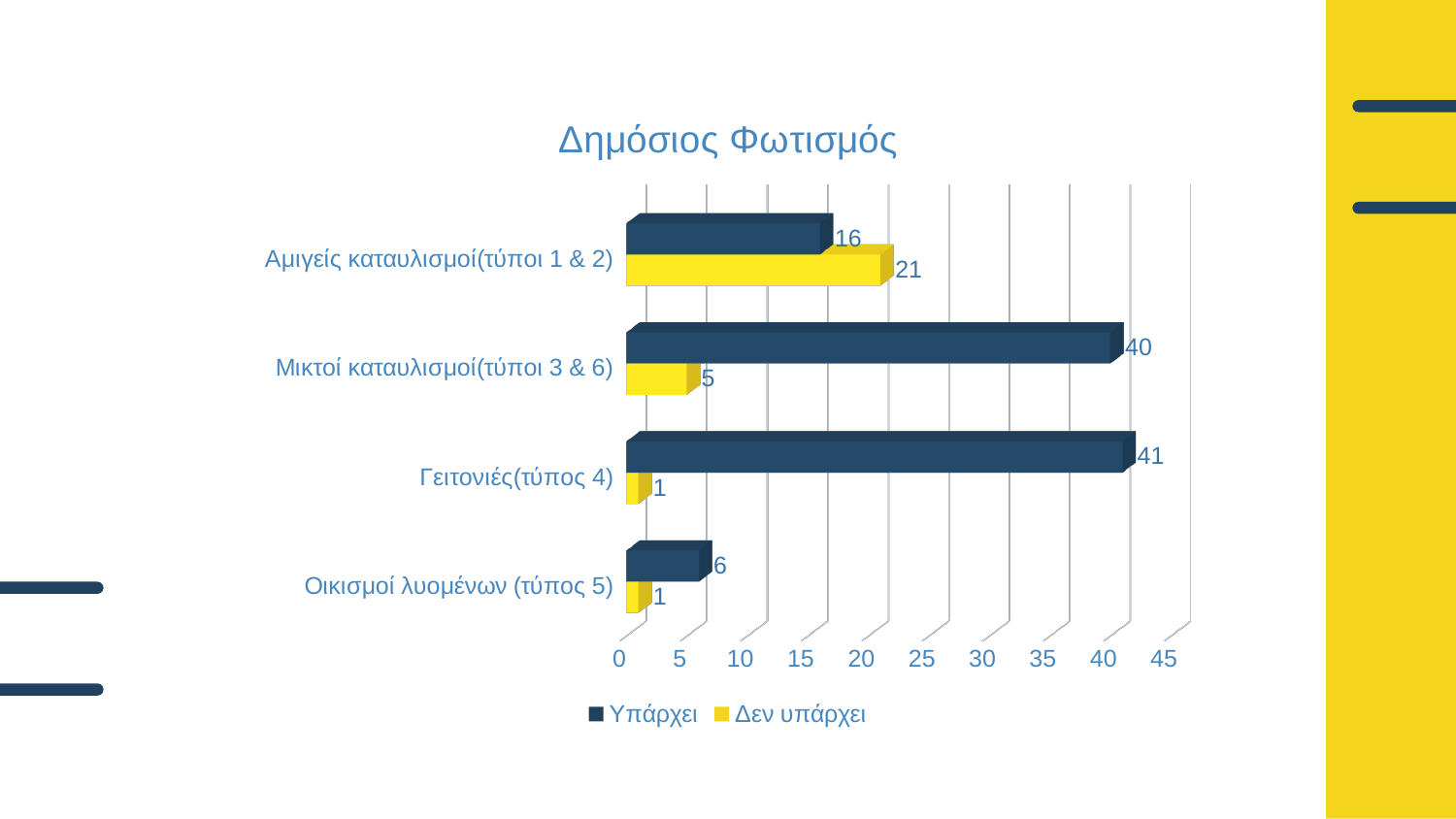
What is the value of Δεν υπάρχει for Αμιγείς καταυλισμοί(τύποι 1 & 2)? 21 For Αμιγείς καταυλισμοί(τύποι 1 & 2), which is larger: Υπάρχει or Δεν υπάρχει? Δεν υπάρχει How many series does the legend list? 2 What is the difference between Υπάρχει and Δεν υπάρχει for Μικτοί καταυλισμοί(τύποι 3 & 6)? 35 Which category has the lowest Υπάρχει value? Οικισμοί λυομένων (τύπος 5) What is the value of Υπάρχει for Μικτοί καταυλισμοί(τύποι 3 & 6)? 40 Which category has the highest Δεν υπάρχει value? Αμιγείς καταυλισμοί(τύποι 1 & 2) What is the title of the chart? Δημόσιος Φωτισμός How many categories are shown on the chart? 4 What is the value of Δεν υπάρχει for Γειτονιές(τύπος 4)? 1 What is the value of Υπάρχει for Αμιγείς καταυλισμοί(τύποι 1 & 2)? 16 Which category has the highest Υπάρχει value? Γειτονιές(τύπος 4)